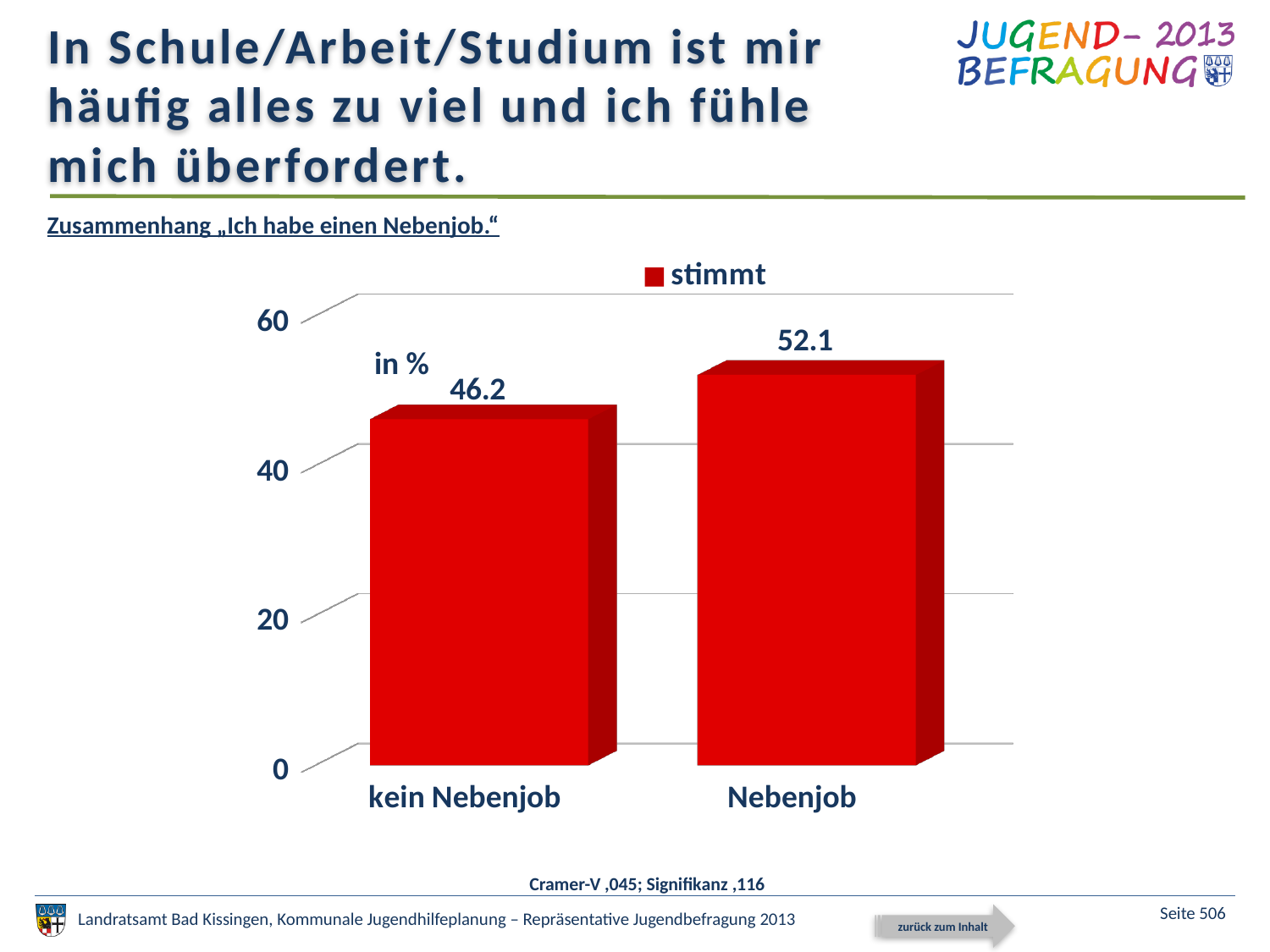
What is the value for "Nebenjob"? 52.1 What is the value for "kein Nebenjob"? 46.2 How many series does the legend list? 1 Which category has the highest value? Nebenjob Which is larger, the value for "kein Nebenjob" or the value for "Nebenjob"? Nebenjob What is the difference between the values for "Nebenjob" and "kein Nebenjob"? 5.9 What is the legend entry of the series shown in the chart? stimmt Is the value for "Nebenjob" greater or less than 60? less How many categories are shown on the x axis? 2 Which category has the lowest value? kein Nebenjob Is the value for "kein Nebenjob" greater or less than 40? greater What kind of chart is shown on the slide? bar chart